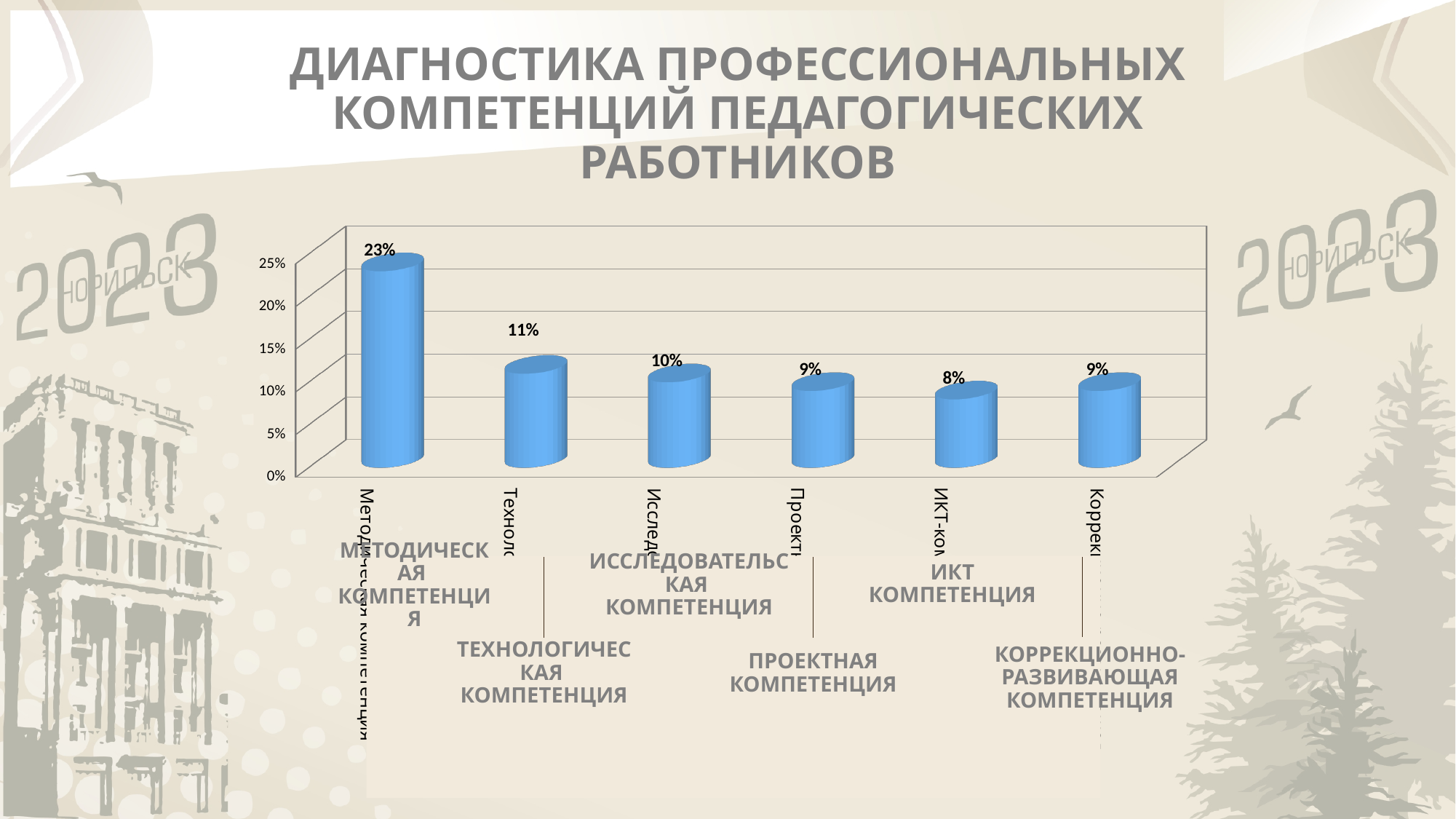
What is the value for Методическая компетенция? 23% Which category has the lowest value? ИКТ компетенция What is the value for ИКТ компетенция? 8% What kind of chart is shown on the slide? Bar chart What is the value for Технологическая компетенция? 11% What is the difference between the values for Методическая компетенция and Технологическая компетенция? 12% Which category has the highest value? Методическая компетенция Which is larger, the value for Технологическая компетенция or the value for Проектная компетенция? Технологическая компетенция How many categories are shown in the chart? 6 What is the value for Коррекционно-развивающая компетенция? 9% What is the difference between the values for Исследовательская компетенция and ИКТ компетенция? 2% Is the value for Методическая компетенция greater or less than 20%? greater